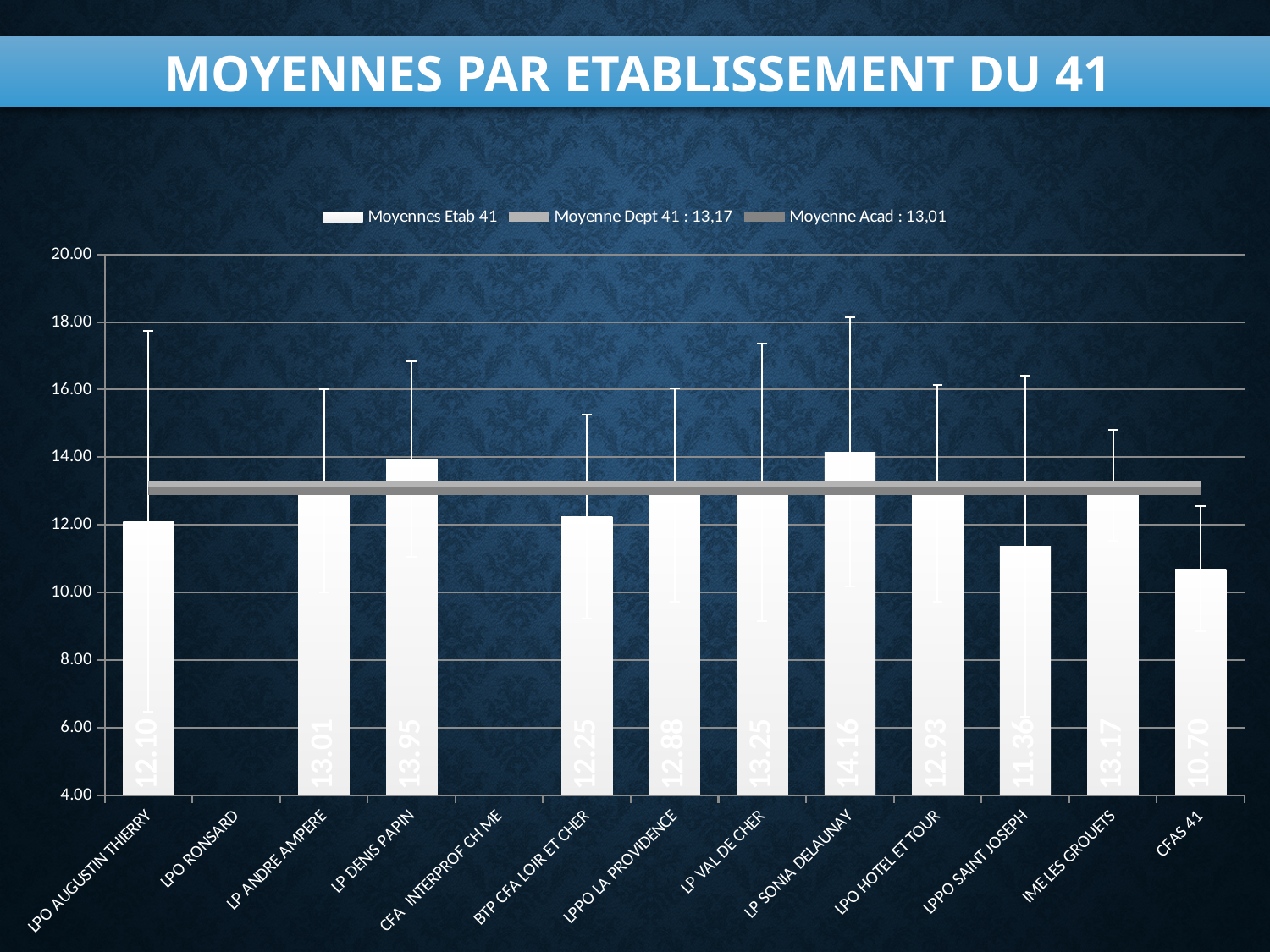
What is the value for CFAS 41? 10.70 Which establishment has the highest average? LP SONIA DELAUNAY What is the value for LP SONIA DELAUNAY? 14.16 Which is larger, the value for LP VAL DE CHER or the value for LPPO LA PROVIDENCE? LP VAL DE CHER How many establishments are listed on the x axis? 13 Which establishment has the lowest average? CFAS 41 Is the value for LPO AUGUSTIN THIERRY greater or less than 14.00? less What is the value for LP DENIS PAPIN? 13.95 How many series does the legend list? 3 What kind of chart is this? bar chart What is the value for LPPO SAINT JOSEPH? 11.36 What is the difference between the values for LP SONIA DELAUNAY and CFAS 41? 3.46